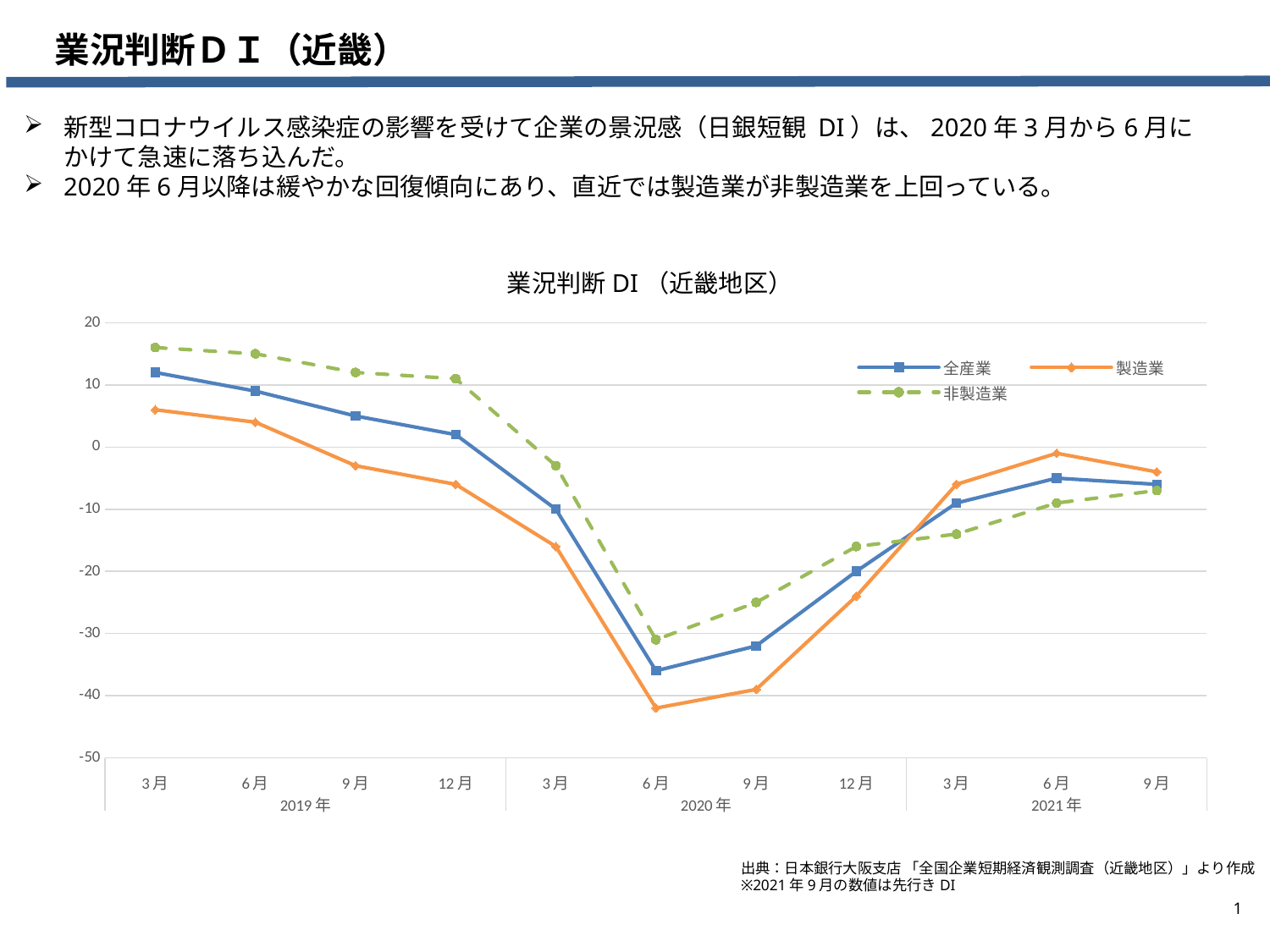
In 2019年3月, which is higher, 製造業 or 非製造業? 非製造業 Which series is drawn with a dashed green line? 非製造業 Is the value for 製造業 in 2020年6月 greater or less than -40? less What kind of chart is shown on the slide? line chart Is the value for 非製造業 in 2019年3月 greater or less than 10? greater What is the title of the chart? 業況判断DI（近畿地区） How many series does the chart legend list? 3 In 2021年9月, which is higher, 製造業 or 非製造業? 製造業 Is the value for 全産業 in 2020年6月 greater or less than -30? less How many time points are plotted along the x axis of the chart? 11 At which time point does the 製造業 series reach its lowest value? 2020年6月